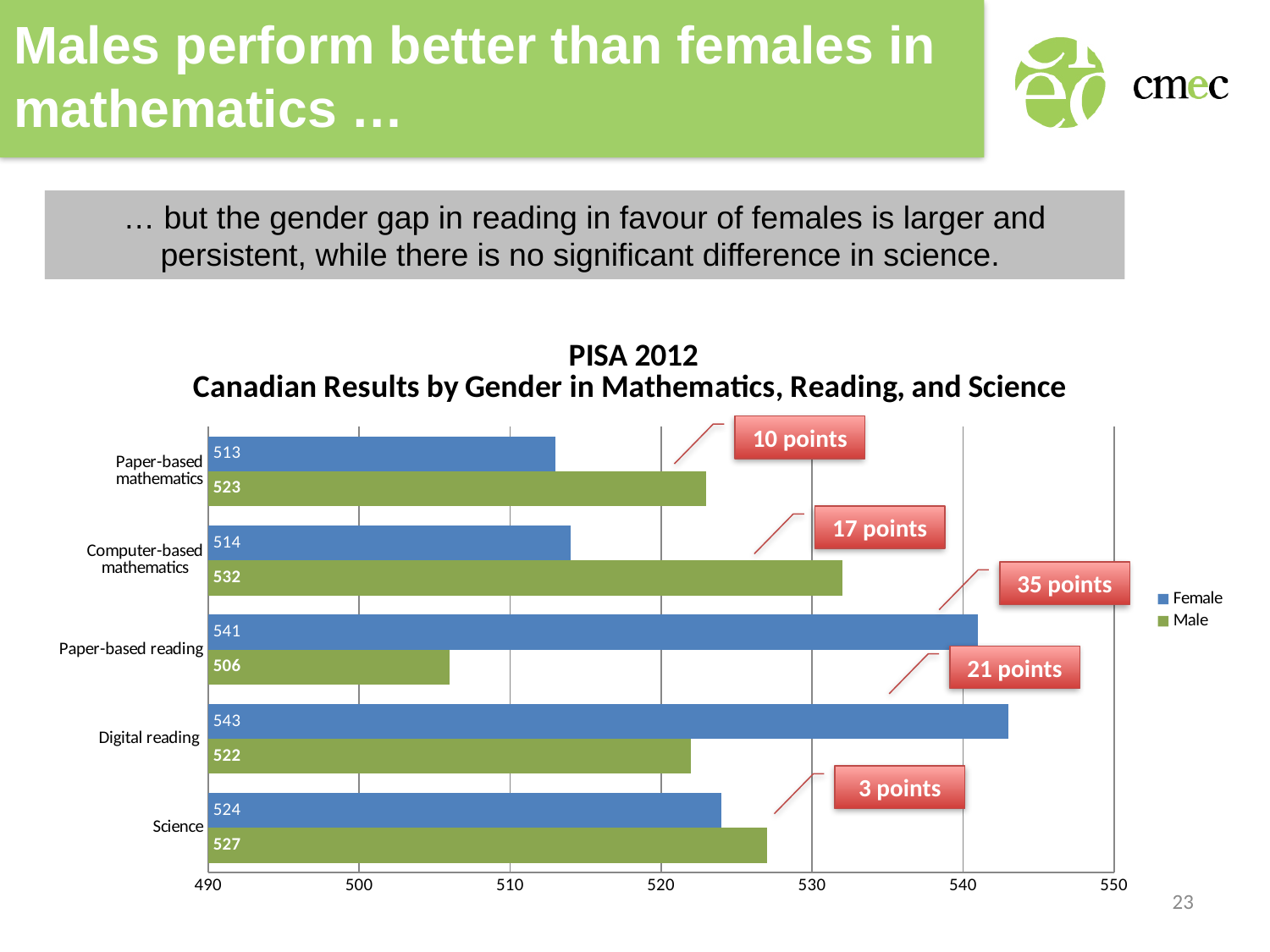
What is the Female value for Paper-based mathematics? 513 Is the Male value for Digital reading greater or less than 520? greater Which category has the highest Female value? Digital reading What is the Male value for Science? 527 What is the Male value for Computer-based mathematics? 532 What kind of chart is shown on the slide? Bar chart Which is larger for Computer-based mathematics, the Female value or the Male value? Male Which category has the lowest Male value? Paper-based reading How many categories are shown on the chart? 5 What is the difference between the Female and Male values for Paper-based reading? 35 What is the Female value for Digital reading? 543 How many series does the legend list? 2